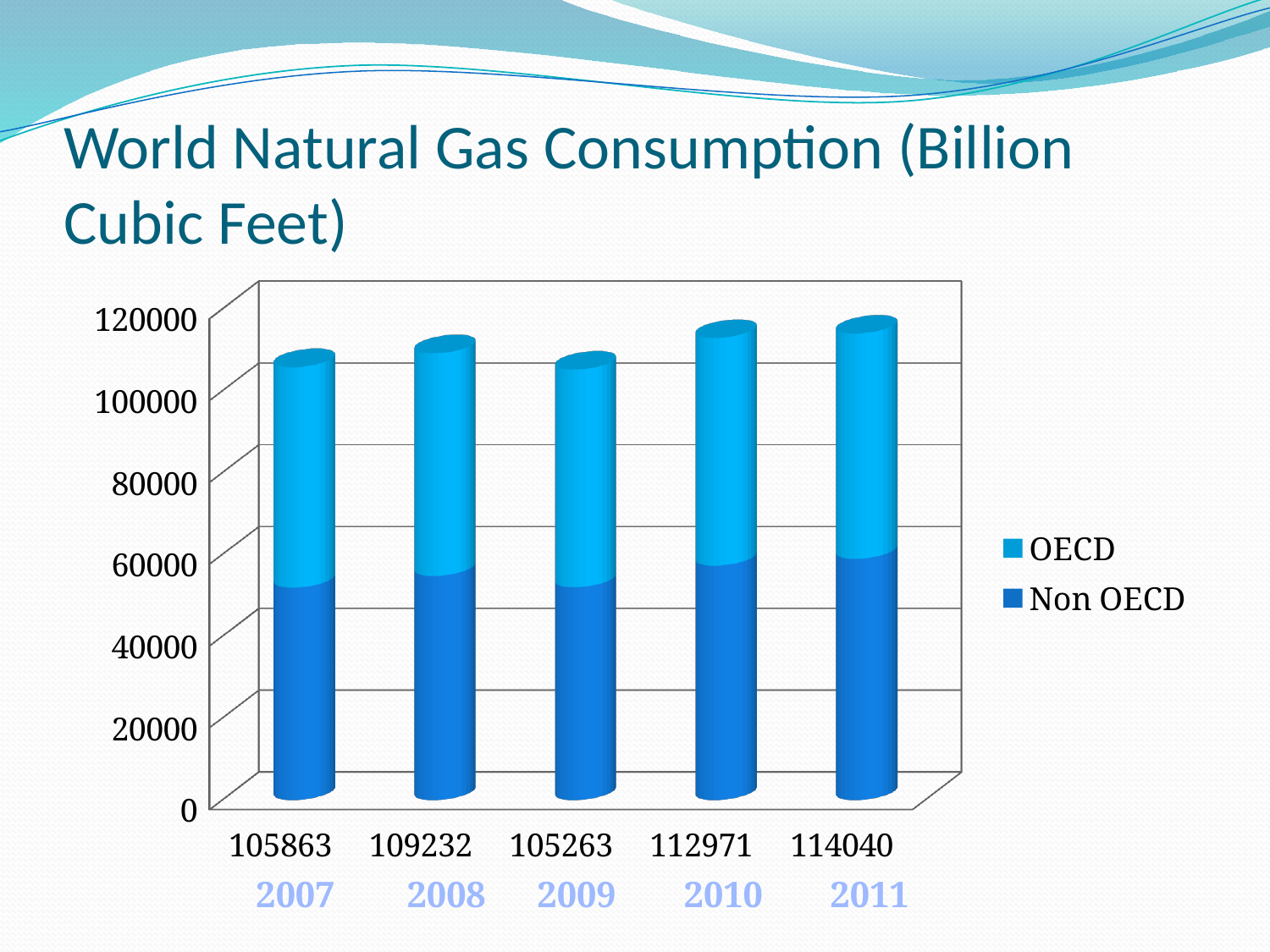
What kind of chart is shown on the slide? Stacked bar chart What is the difference between the total for 2010 and the total for 2009? 7708 What is the difference between the total for 2011 and the total for 2007? 8177 What is the total value printed for 2009? 105263 Which year has the lowest total consumption? 2009 Which year has the larger total, 2007 or 2008? 2008 What is the total world natural gas consumption shown for 2011? 114040 Is the Non OECD value for 2007 greater or less than 40000? greater How many series does the legend list? 2 What is the total value printed for 2008? 109232 Which year has the highest total consumption? 2011 How many years are shown on the x axis? 5